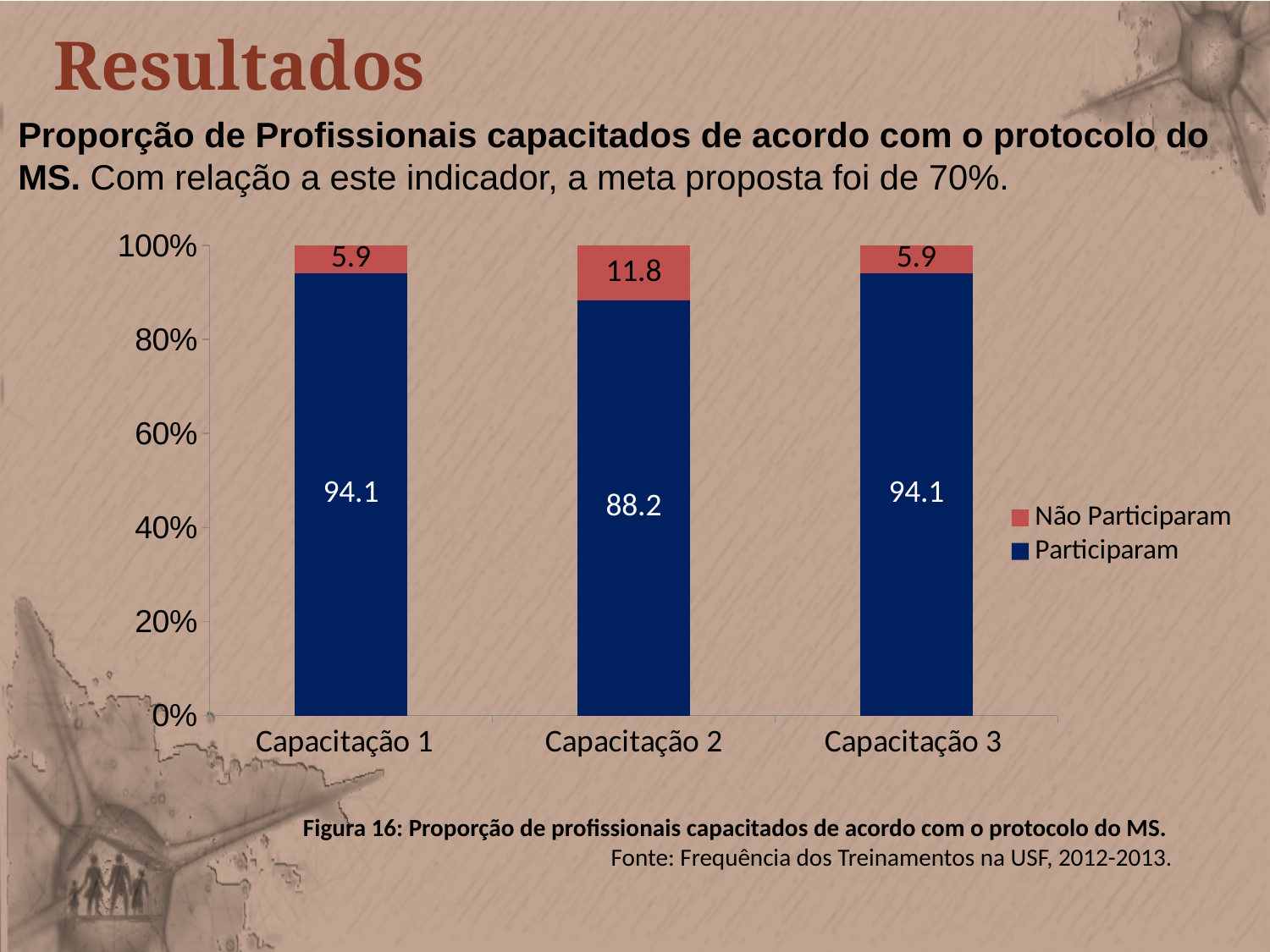
How many series does the legend list? 2 Which category has the lowest value for Participaram? Capacitação 2 What kind of chart is shown on the slide? Stacked bar chart Which is larger: the Não Participaram value for Capacitação 2 or for Capacitação 3? Capacitação 2 Which category has the highest value for Não Participaram? Capacitação 2 How many categories are shown on the x axis? 3 What is the difference between the Participaram values for Capacitação 1 and Capacitação 2? 5.9 What is the value for Não Participaram in Capacitação 2? 11.8 What is the value for Não Participaram in Capacitação 3? 5.9 What is the value for Participaram in Capacitação 1? 94.1 What is the value for Participaram in Capacitação 2? 88.2 Which series is shown in dark blue? Participaram